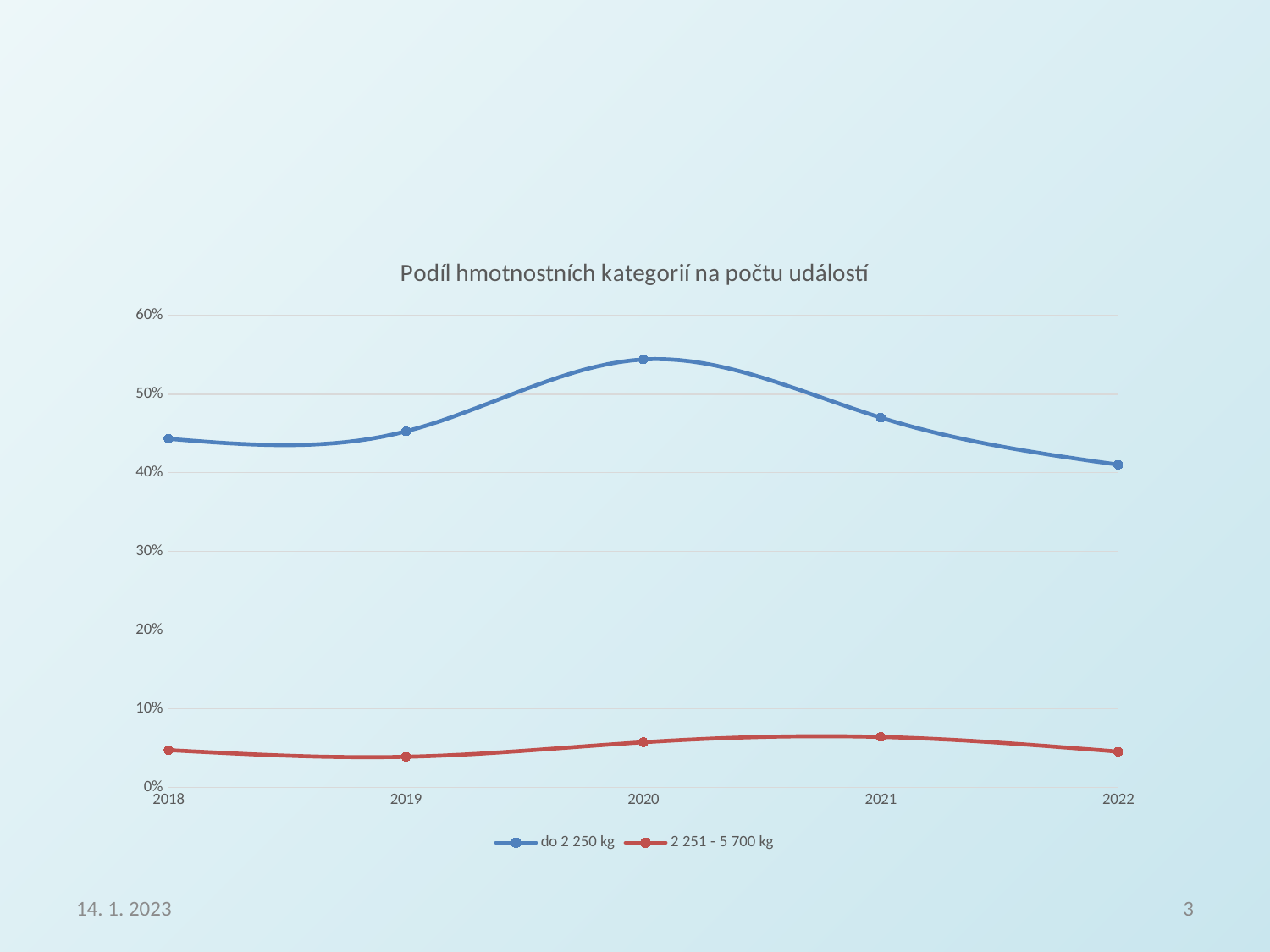
Does the 'do 2 250 kg' series rise or fall between 2020 and 2022? fall Is the value for 'do 2 250 kg' in 2020 greater or less than 50%? greater What kind of chart is shown on the slide? line chart Is the value for '2 251 - 5 700 kg' in 2021 greater or less than 10%? less In which year does the 'do 2 250 kg' series reach its highest value? 2020 In which year does the 'do 2 250 kg' series have its lowest value? 2022 What is the title of the chart? Podíl hmotnostních kategorií na počtu událostí How many series does the legend list? 2 Which series has the larger value in 2020, 'do 2 250 kg' or '2 251 - 5 700 kg'? do 2 250 kg In which year does the '2 251 - 5 700 kg' series have its lowest value? 2019 Is the value for 'do 2 250 kg' in 2022 greater or less than 50%? less How many years are plotted along the x axis? 5